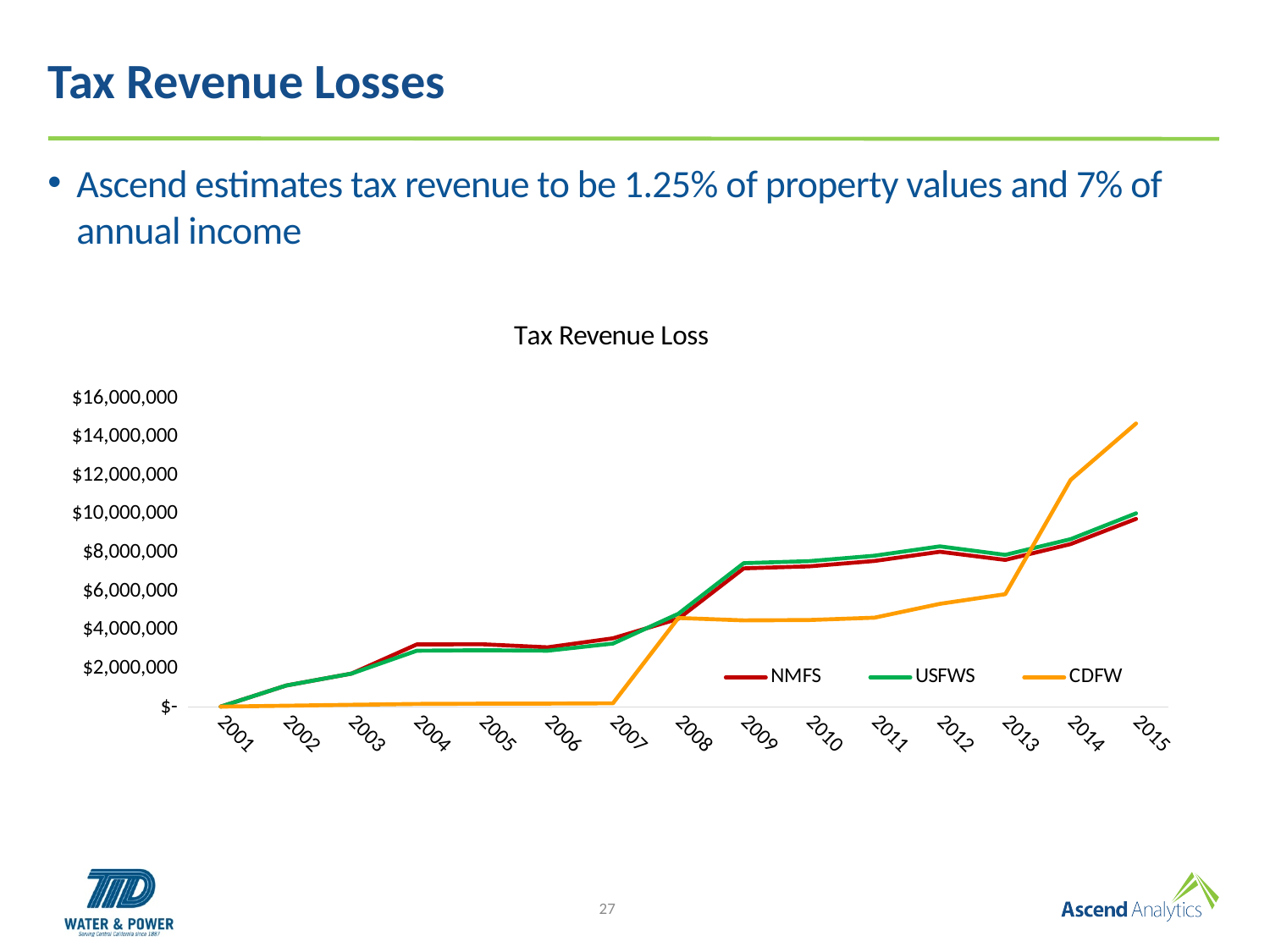
Which series has the highest value in 2015? CDFW Is the value for CDFW in 2015 greater or less than $12,000,000? greater Does the CDFW series rise or fall from 2007 to 2015? rise Which series has the lowest value in 2005? CDFW How many years are plotted along the x axis of the Tax Revenue Loss chart? 15 Is the value for NMFS in 2009 greater or less than $6,000,000? greater How many series does the legend of the Tax Revenue Loss chart list? 3 In 2007, which is larger, the value for USFWS or the value for CDFW? USFWS Which series is drawn in orange in the Tax Revenue Loss chart? CDFW What is the title of the chart on the slide? Tax Revenue Loss What kind of chart is shown on the slide? line chart In 2015, which is larger, the value for CDFW or the value for NMFS? CDFW